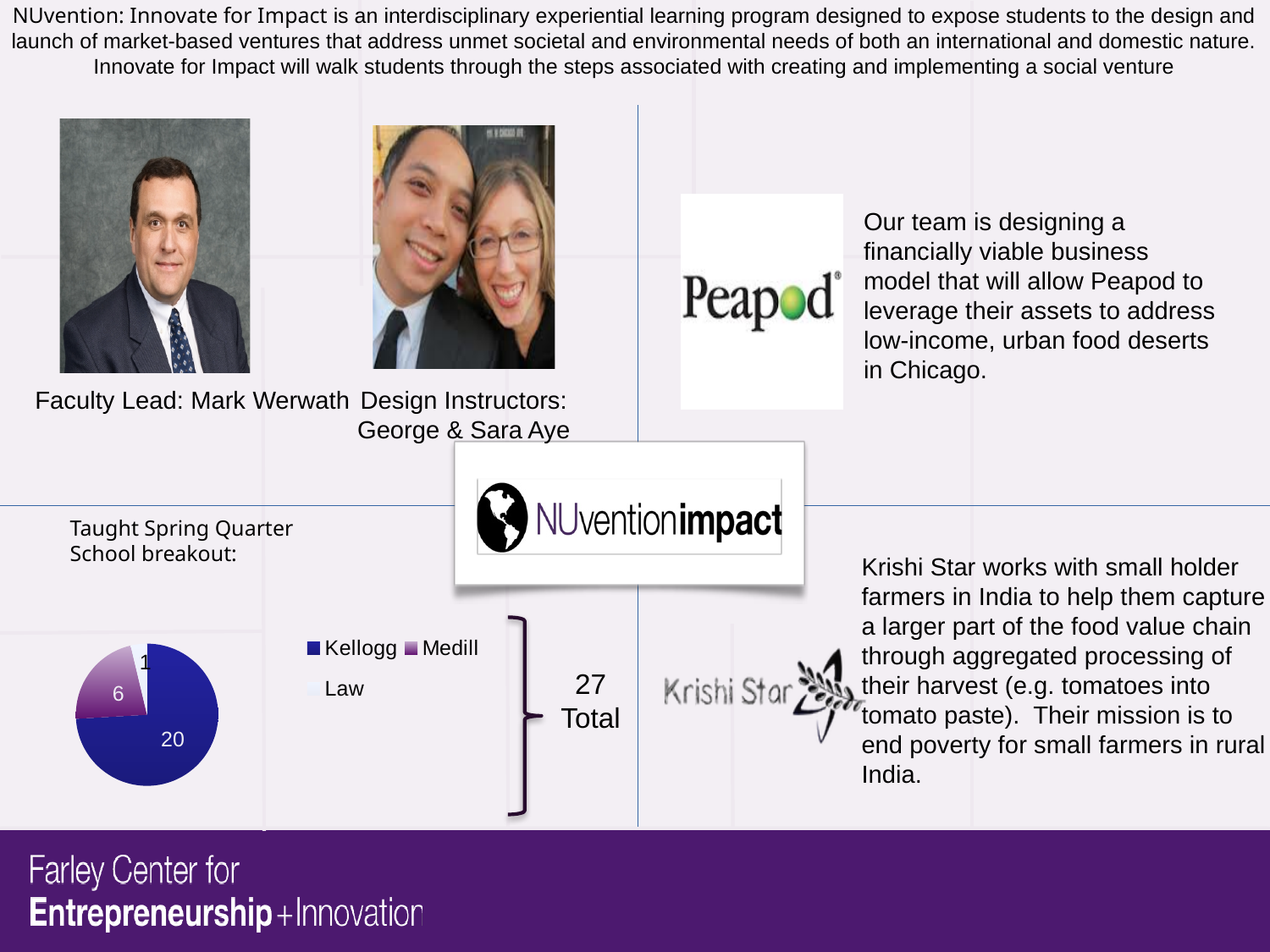
What is the value for Kellogg in the pie chart? 20 Which is larger in the pie chart, Medill or Law? Medill Which school has the largest slice in the pie chart? Kellogg What is the difference between the Medill and Law values in the pie chart? 5 What is the value for Law in the pie chart? 1 What kind of chart is shown on the slide? pie chart What is the total of all slices in the pie chart? 27 Which schools are listed in the pie chart's legend? Kellogg, Medill, Law Which school has the smallest slice in the pie chart? Law What is the value for Medill in the pie chart? 6 How many slices does the pie chart have? 3 What is the difference between the Kellogg and Medill values in the pie chart? 14